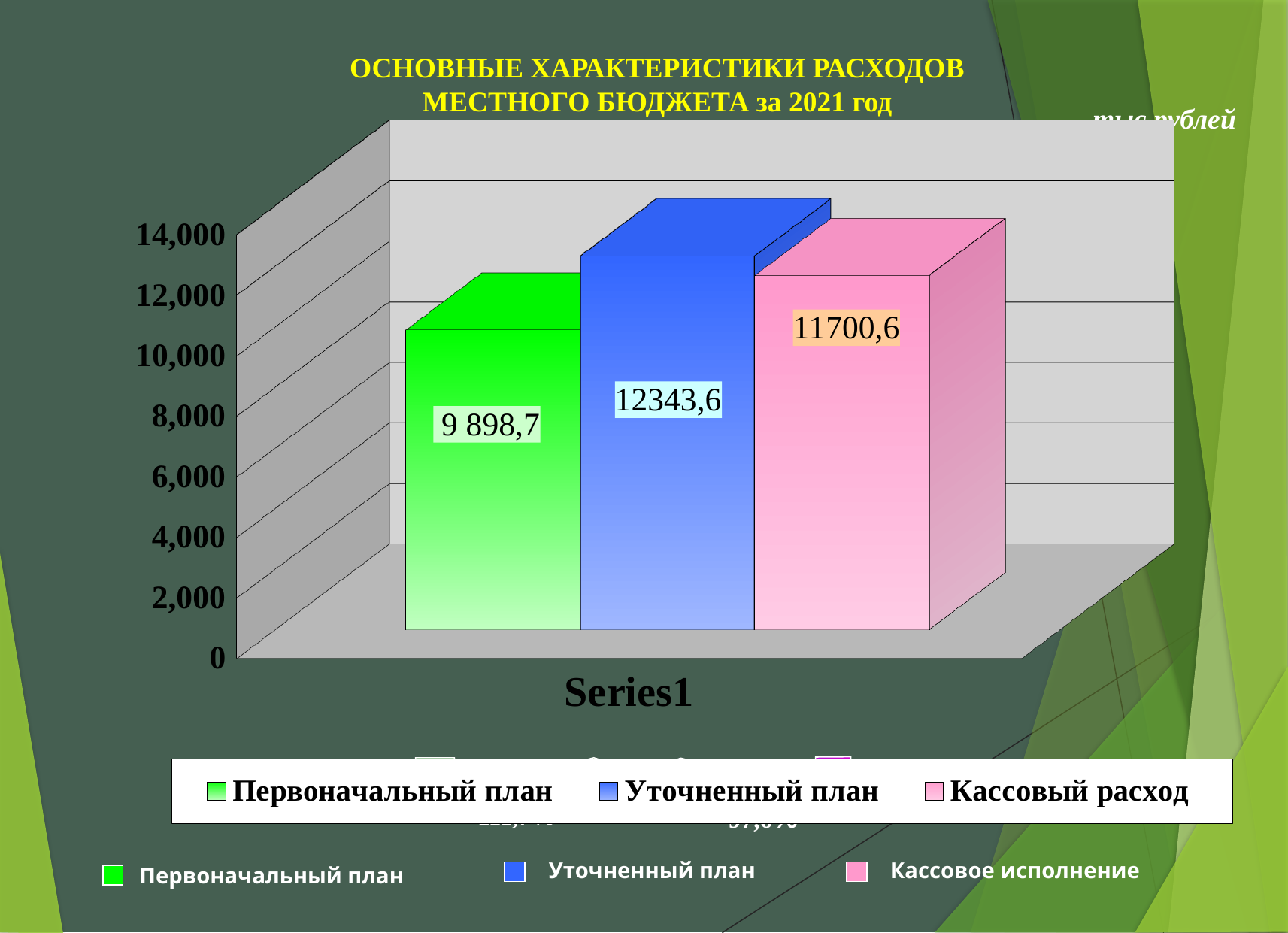
What is the difference between Уточненный план and Кассовый расход? 643,0 Which series has the lowest value? Первоначальный план What is the value for Уточненный план? 12343,6 Which is larger, Кассовый расход or Первоначальный план? Кассовый расход Which series has the highest value? Уточненный план Is the value for Уточненный план greater or less than 12,000? greater What is the value for Первоначальный план? 9 898,7 What kind of chart is shown on the slide? bar chart How many series does the legend list? 3 What is the value for Кассовый расход? 11700,6 What unit is indicated for the values on the chart? тыс.рублей What is the difference between Уточненный план and Первоначальный план? 2444,9